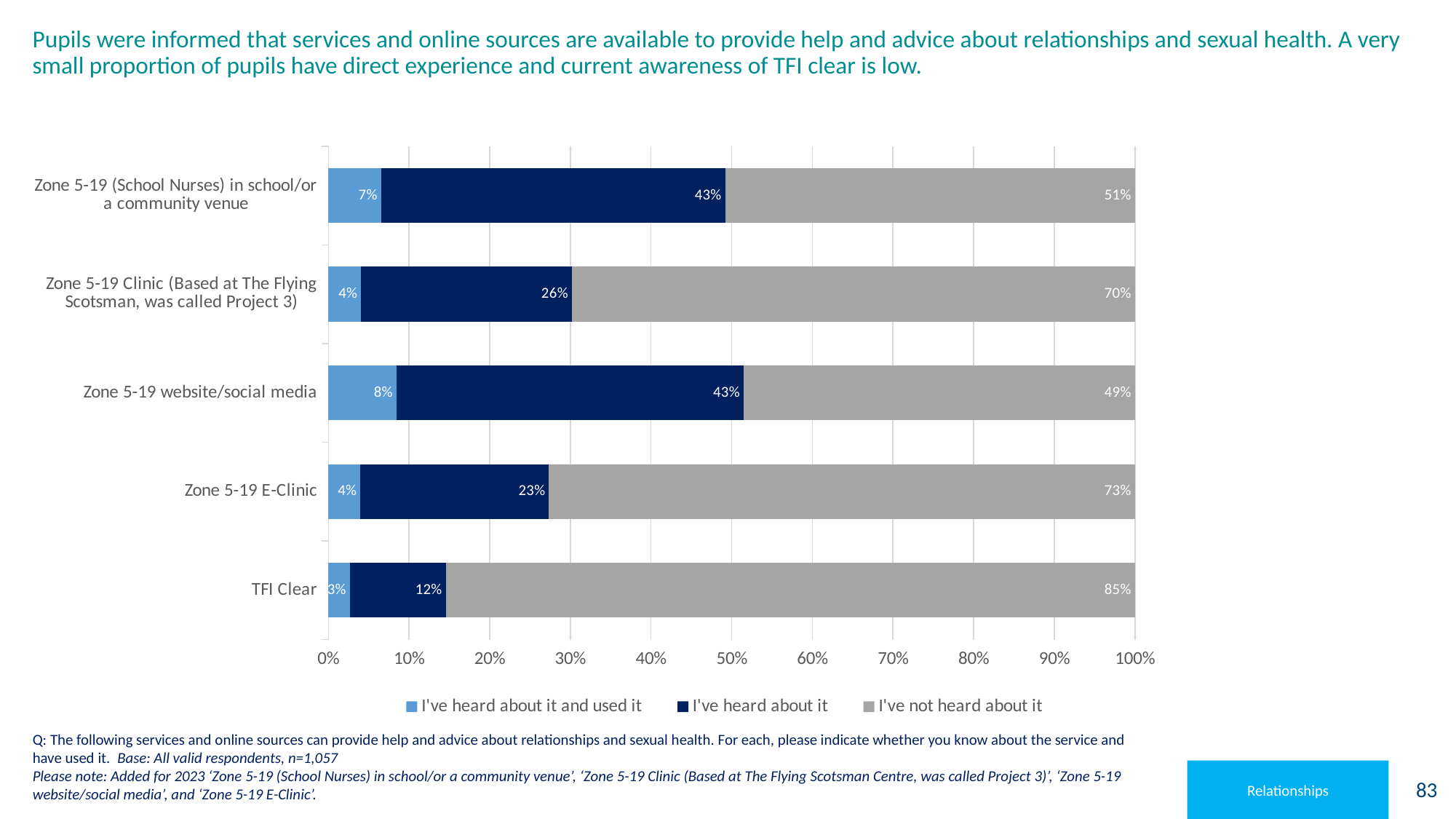
What is the combined percentage of pupils who have heard about Zone 5-19 (School Nurses) in school/or a community venue, including those who have used it? 50% What percentage of pupils have heard about and used Zone 5-19 website/social media? 8% How many services are shown in the chart? 5 Which service has the lowest percentage of pupils who have heard about it? TFI Clear What percentage of pupils have not heard about TFI Clear? 85% How many series does the legend list? 3 Which service has the highest percentage of pupils who have not heard about it? TFI Clear What is the difference between the 'I've not heard about it' percentages for Zone 5-19 E-Clinic and Zone 5-19 website/social media? 24% What percentage of pupils have heard about Zone 5-19 Clinic (Based at The Flying Scotsman, was called Project 3)? 26% What kind of chart is shown on the slide? Stacked bar chart Which colour represents 'I've not heard about it' in the chart? Grey Which is larger: the 'I've heard about it' percentage for Zone 5-19 E-Clinic or for Zone 5-19 Clinic (Based at The Flying Scotsman, was called Project 3)? Zone 5-19 Clinic (Based at The Flying Scotsman, was called Project 3)